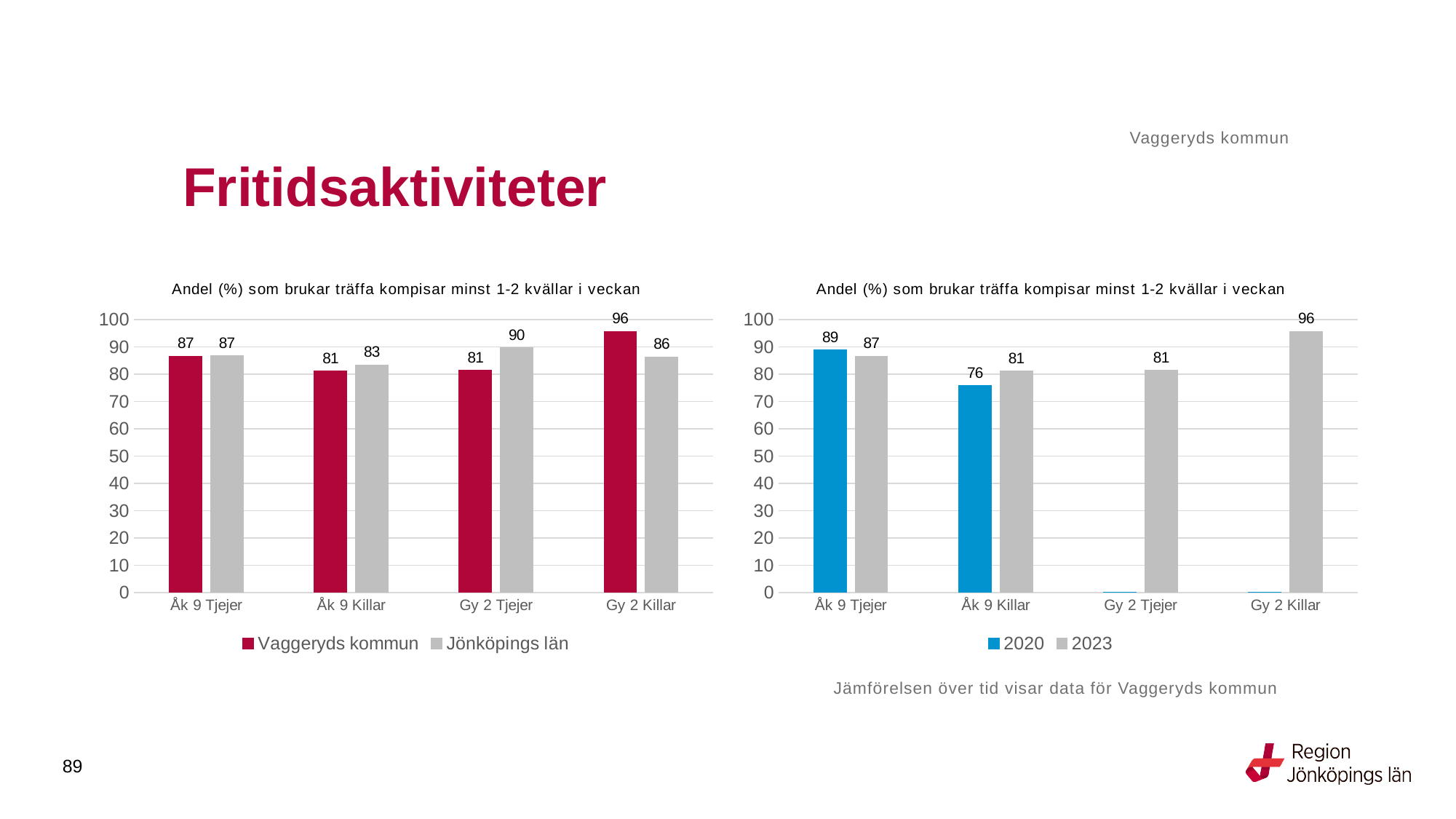
In the left chart, which is larger for Åk 9 Killar: Vaggeryds kommun or Jönköpings län? Jönköpings län In the right chart, how many categories are shown on the x axis? 4 In the left chart, how many series does the legend list? 2 In the left chart, what is the value for Jönköpings län for Gy 2 Tjejer? 90 In the right chart, what is the value for 2020 for Åk 9 Killar? 76 In the left chart, what is the value for Vaggeryds kommun for Gy 2 Killar? 96 In the left chart, what is the difference between Jönköpings län and Vaggeryds kommun for Gy 2 Tjejer? 9 In the right chart, what is the difference between 2023 and 2020 for Åk 9 Killar? 5 In the left chart, which category has the highest value for Vaggeryds kommun? Gy 2 Killar What kind of chart is the left chart? Bar chart In the right chart, what is the value for 2023 for Gy 2 Killar? 96 In the right chart, which category has the lowest value for 2023? Åk 9 Killar and Gy 2 Tjejer (both 81)